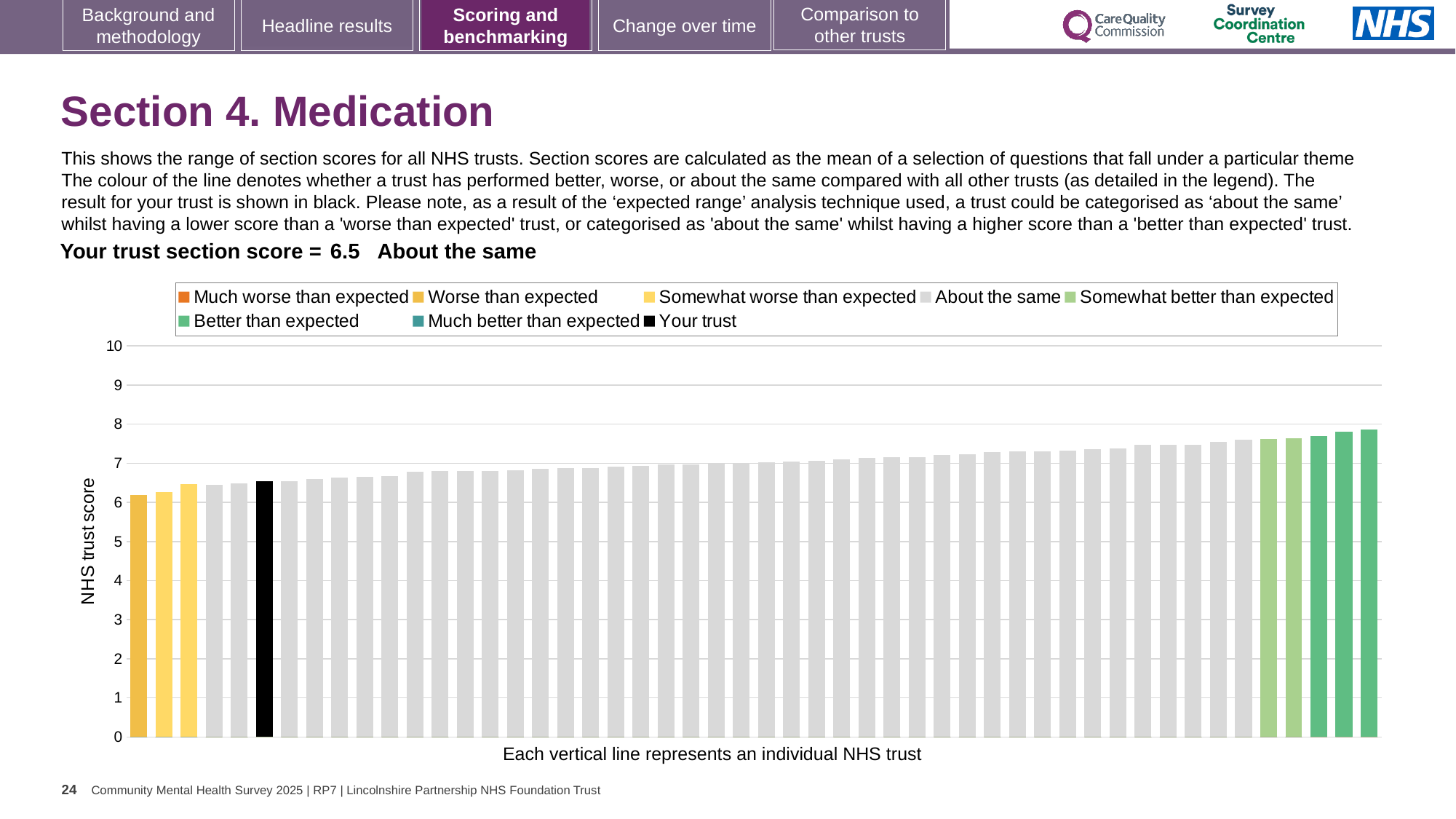
Do the bar values rise or fall from left to right along the x axis? rise Is the value of the black bar (your trust) greater or less than 7? less Is the value of the tallest bar in the chart greater or less than 7? greater Is the value of the tallest bar in the chart greater or less than 8? less Which category does your trust fall into according to the text above the chart? About the same How many entries does the chart legend list? 8 What is the section score for your trust shown on the slide? 6.5 What type of chart is shown on the slide? bar chart Which bar is taller: the black bar for your trust or the rightmost bar? the rightmost bar What is the label on the vertical axis of the chart? NHS trust score What is the highest value shown on the vertical axis of the chart? 10